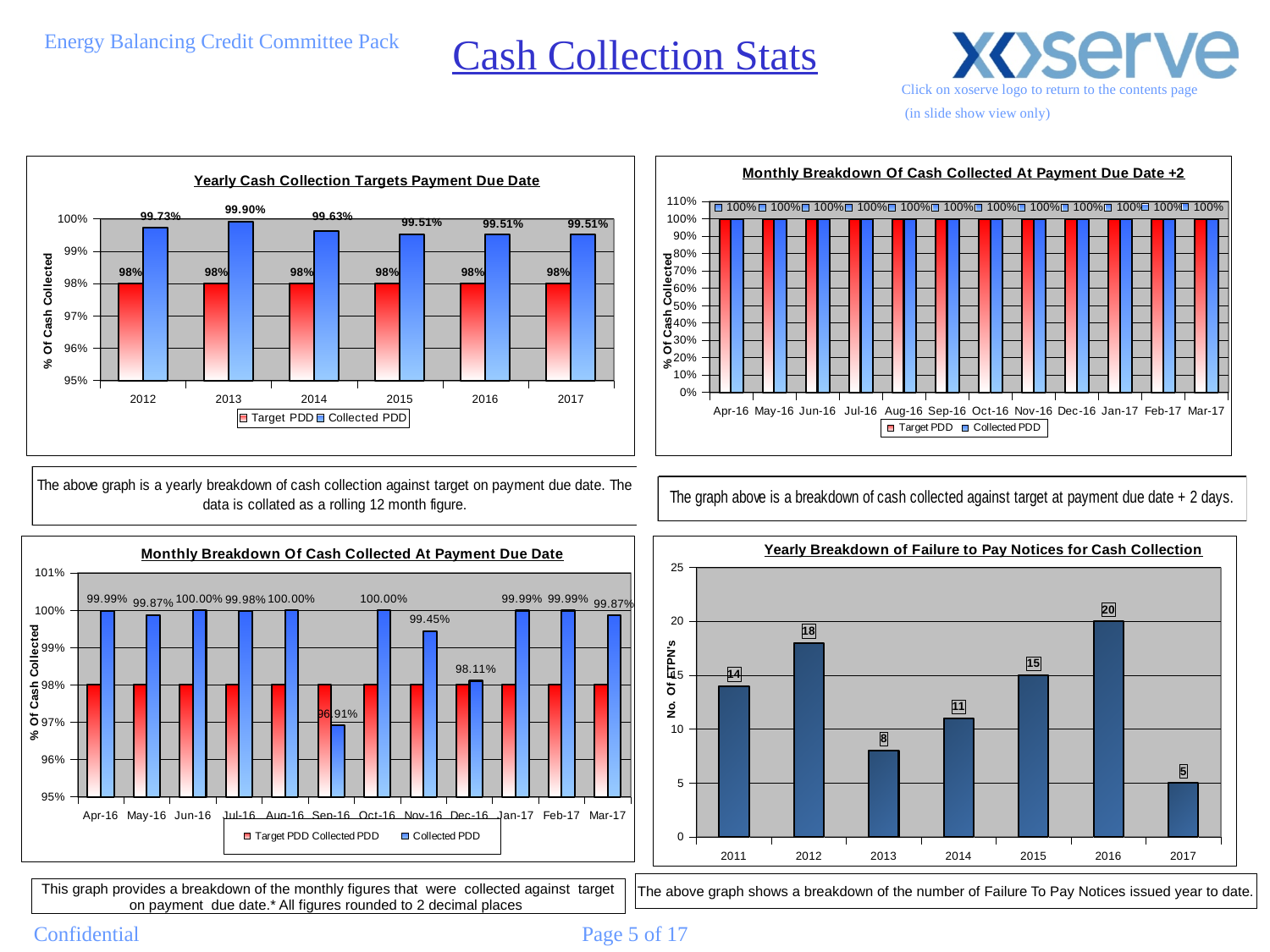
In the 'Yearly Breakdown of Failure to Pay Notices for Cash Collection' chart, which year has the lowest number of notices? 2017 In the 'Yearly Cash Collection Targets Payment Due Date' chart, what is the Target PDD value for 2015? 98% In the 'Yearly Breakdown of Failure to Pay Notices for Cash Collection' chart, what is the difference between the 2012 and 2013 values? 10 In the 'Monthly Breakdown Of Cash Collected At Payment Due Date +2' chart, how many months are shown on the x axis? 12 In the 'Monthly Breakdown Of Cash Collected At Payment Due Date' chart, what is the Collected PDD value for Dec-16? 98.11% In the 'Monthly Breakdown Of Cash Collected At Payment Due Date' chart, which month has the lowest Collected PDD value? Sep-16 What kind of chart is the 'Yearly Breakdown of Failure to Pay Notices for Cash Collection' chart? Bar chart In the 'Monthly Breakdown Of Cash Collected At Payment Due Date +2' chart, what is the Collected PDD value for Oct-16? 100% In the 'Monthly Breakdown Of Cash Collected At Payment Due Date' chart, what is the Collected PDD value for Sep-16? 96.91% In the 'Yearly Cash Collection Targets Payment Due Date' chart, which year has the highest Collected PDD value? 2013 In the 'Yearly Cash Collection Targets Payment Due Date' chart, what is the Collected PDD value for 2013? 99.90% In the 'Yearly Breakdown of Failure to Pay Notices for Cash Collection' chart, how many notices were issued in 2016? 20